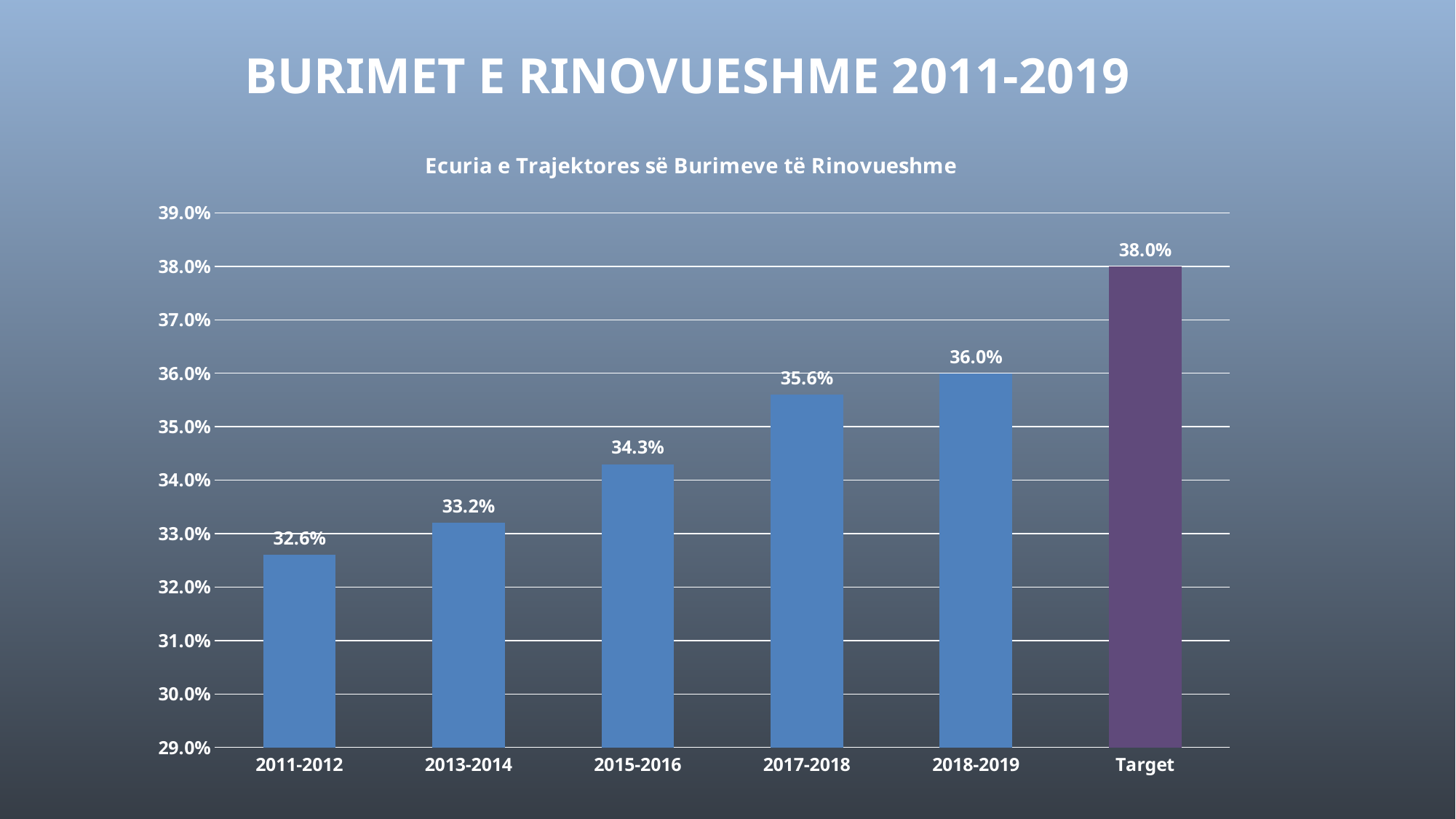
What is the value for 2011-2012? 32.6% Which is larger, the value for 2015-2016 or the value for 2017-2018? 2017-2018 How many bars are shown in the chart? 6 Which category has the lowest value? 2011-2012 What kind of chart is shown on the slide? Bar chart What is the value for the Target bar? 38.0% Do the values rise or fall from 2011-2012 to 2018-2019? Rise Which category has the highest value? Target Is the value for 2018-2019 greater or less than 37.0%? less What is the difference between the Target value and the 2018-2019 value? 2.0% What is the difference between the 2017-2018 value and the 2013-2014 value? 2.4% What is the value for 2015-2016? 34.3%